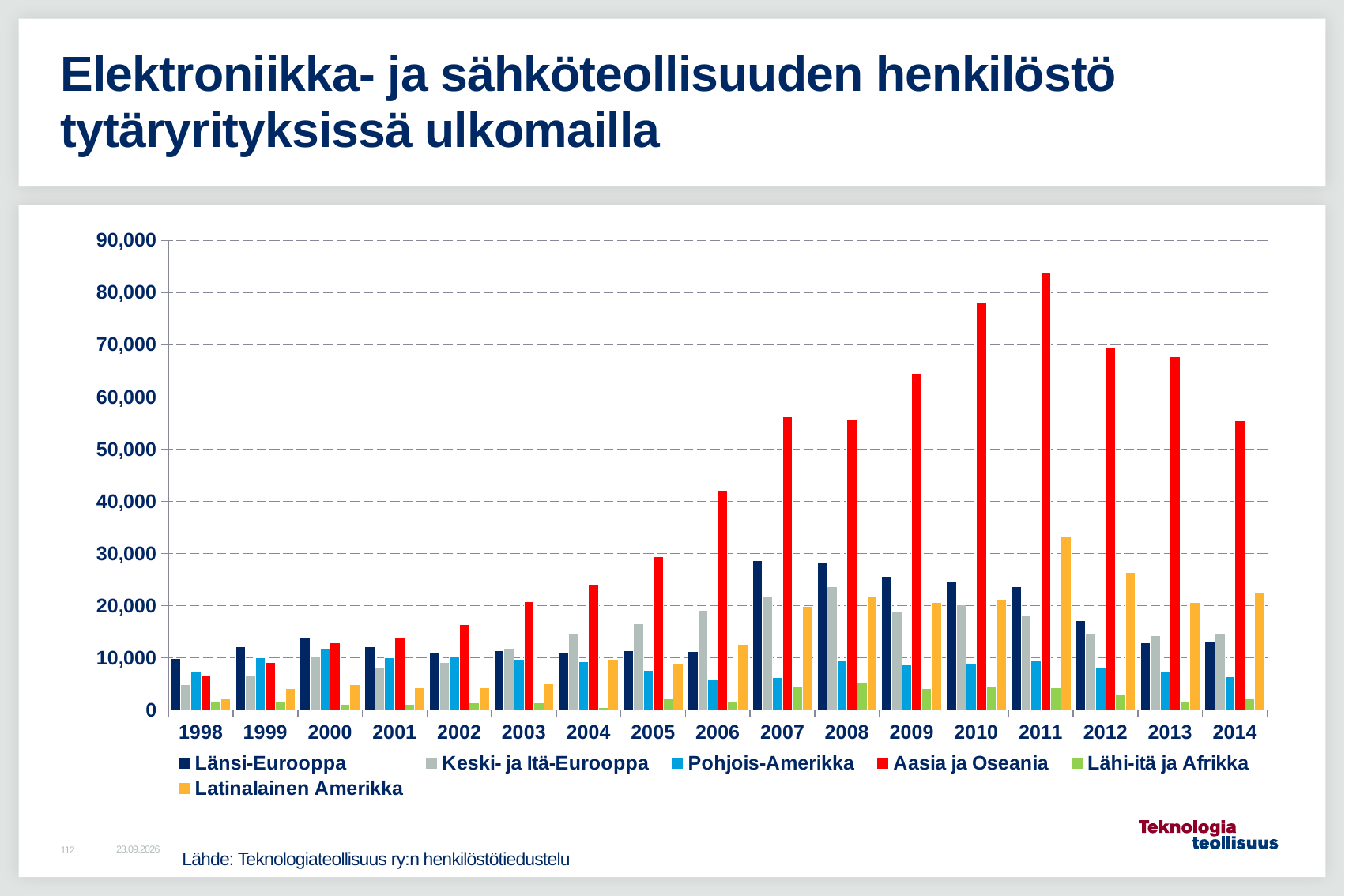
Is the value for Aasia ja Oseania in 2010 greater or less than 70,000? greater In 2014, which is larger: Aasia ja Oseania or Latinalainen Amerikka? Aasia ja Oseania Is the value for Latinalainen Amerikka in 2011 greater or less than 30,000? greater In which year is the value for Aasia ja Oseania highest? 2011 What kind of chart is shown on the slide? Bar chart In which year is the value for Aasia ja Oseania lowest? 1998 Is the value for Aasia ja Oseania in 2011 greater or less than 80,000? greater In which year is the value for Latinalainen Amerikka highest? 2011 In 1998, which is larger: Länsi-Eurooppa or Aasia ja Oseania? Länsi-Eurooppa How many series does the legend list? 6 How many years are shown on the x axis? 17 Does the value for Aasia ja Oseania rise or fall from 1998 to 2011? rise